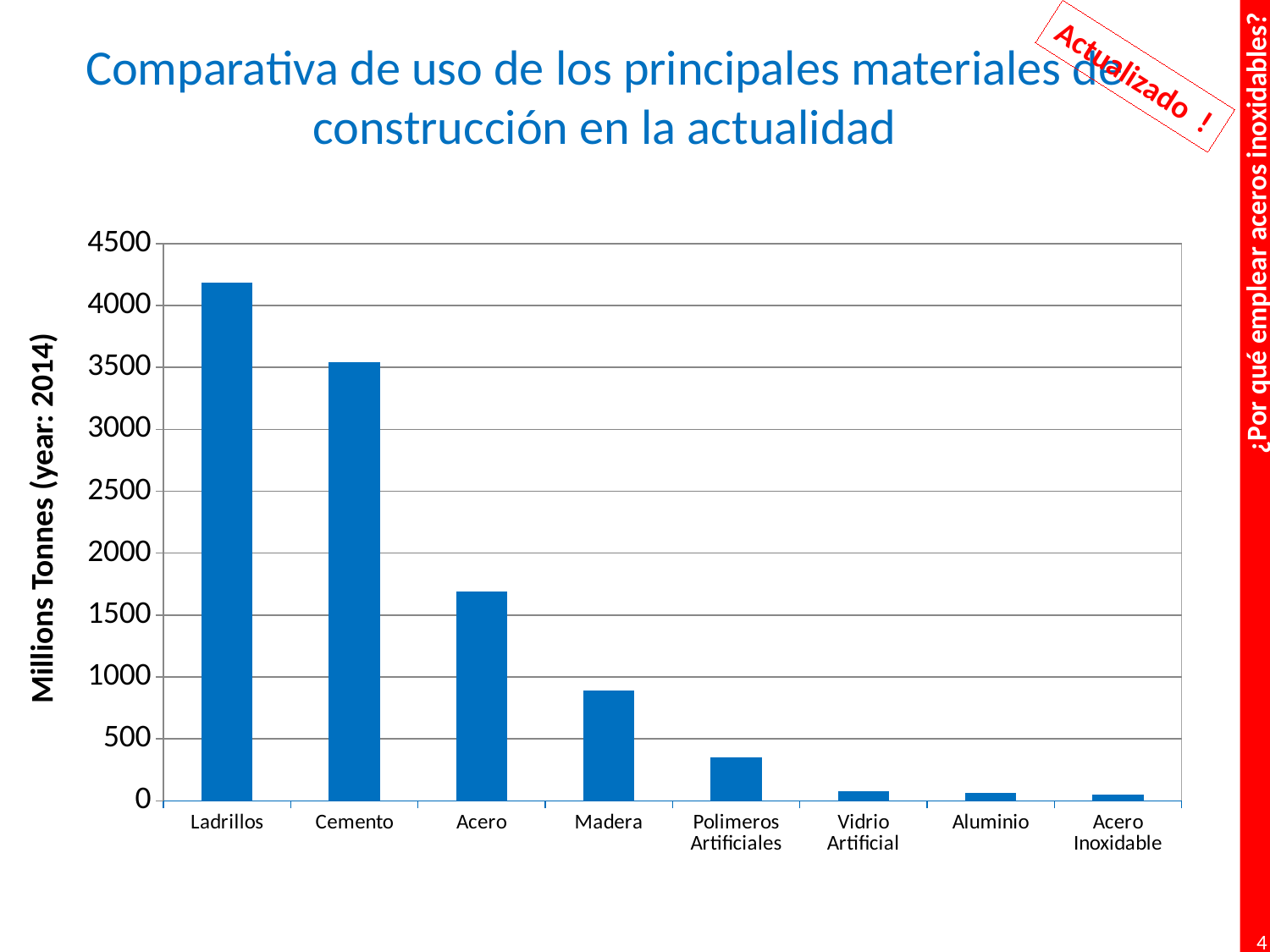
Which is larger, the value for Cemento or the value for Acero? Cemento Is the value for Polimeros Artificiales greater or less than 500? less Which material has the highest value in the chart? Ladrillos Which is larger, the value for Madera or the value for Polimeros Artificiales? Madera Do the values rise or fall moving from left to right along the x axis? fall What kind of chart is shown on the slide? bar chart Is the value for Acero greater or less than 2000? less Is the value for Madera greater or less than 1000? less How many materials (categories) are plotted in the chart? 8 What is the label of the vertical axis of the chart? Millions Tonnes (year: 2014)